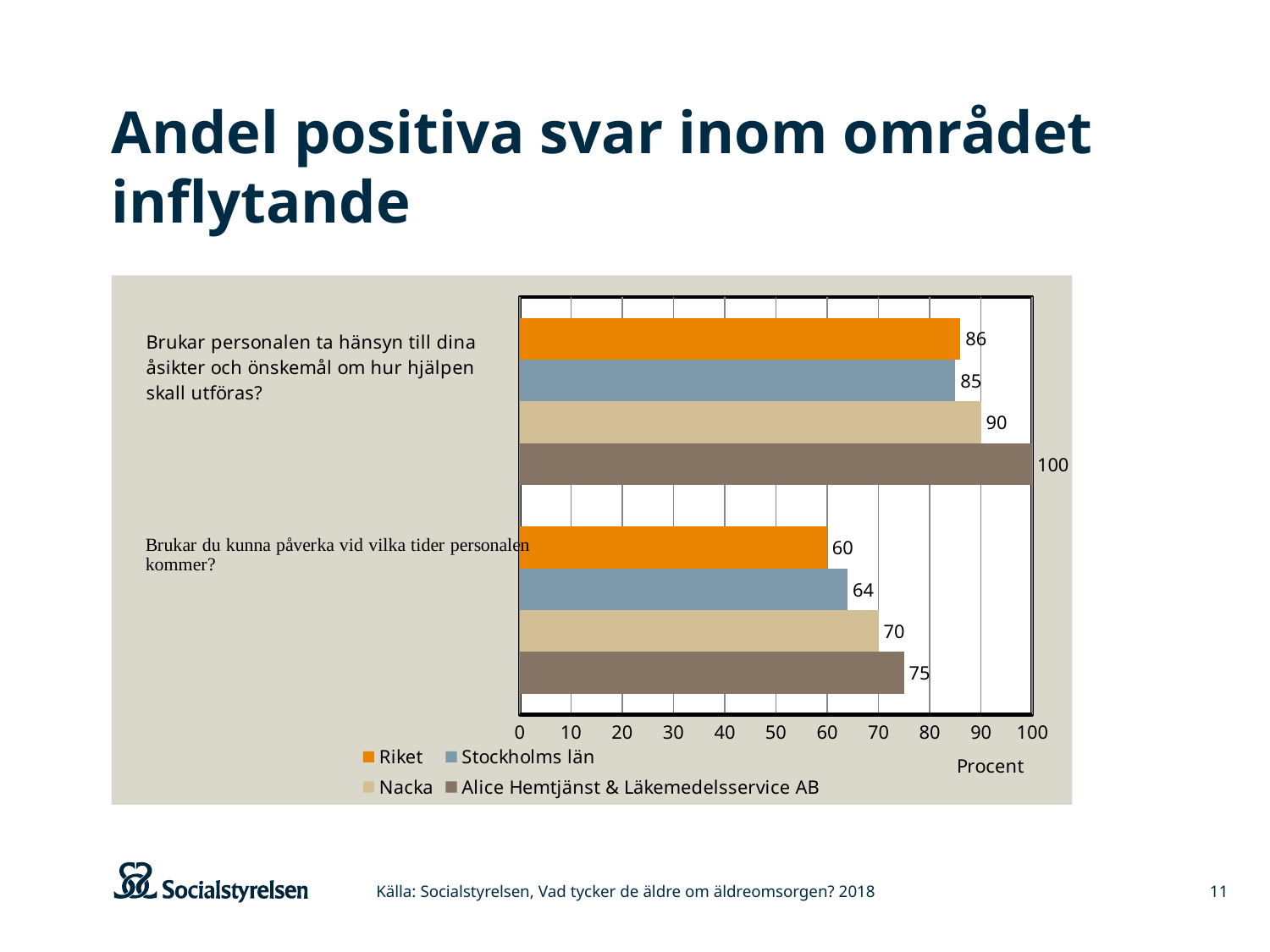
Which series has the highest value on the question "Brukar personalen ta hänsyn till dina åsikter och önskemål om hur hjälpen skall utföras?"? Alice Hemtjänst & Läkemedelsservice AB How many question categories are plotted on the chart? 2 What unit label is shown on the x axis of the chart? Procent Which is larger on the question "Brukar du kunna påverka vid vilka tider personalen kommer?": the value for Stockholms län or the value for Nacka? Nacka What kind of chart is shown on the slide? Bar chart How many series does the legend list? 4 What is the value for Riket on the question "Brukar personalen ta hänsyn till dina åsikter och önskemål om hur hjälpen skall utföras?"? 86 What is the value for Alice Hemtjänst & Läkemedelsservice AB on the question "Brukar du kunna påverka vid vilka tider personalen kommer?"? 75 What is the value for Stockholms län on the question "Brukar personalen ta hänsyn till dina åsikter och önskemål om hur hjälpen skall utföras?"? 85 What is the value for Nacka on the question "Brukar du kunna påverka vid vilka tider personalen kommer?"? 70 What is the difference between the Alice Hemtjänst & Läkemedelsservice AB value and the Riket value on the question "Brukar du kunna påverka vid vilka tider personalen kommer?"? 15 Which series has the lowest value on the question "Brukar du kunna påverka vid vilka tider personalen kommer?"? Riket